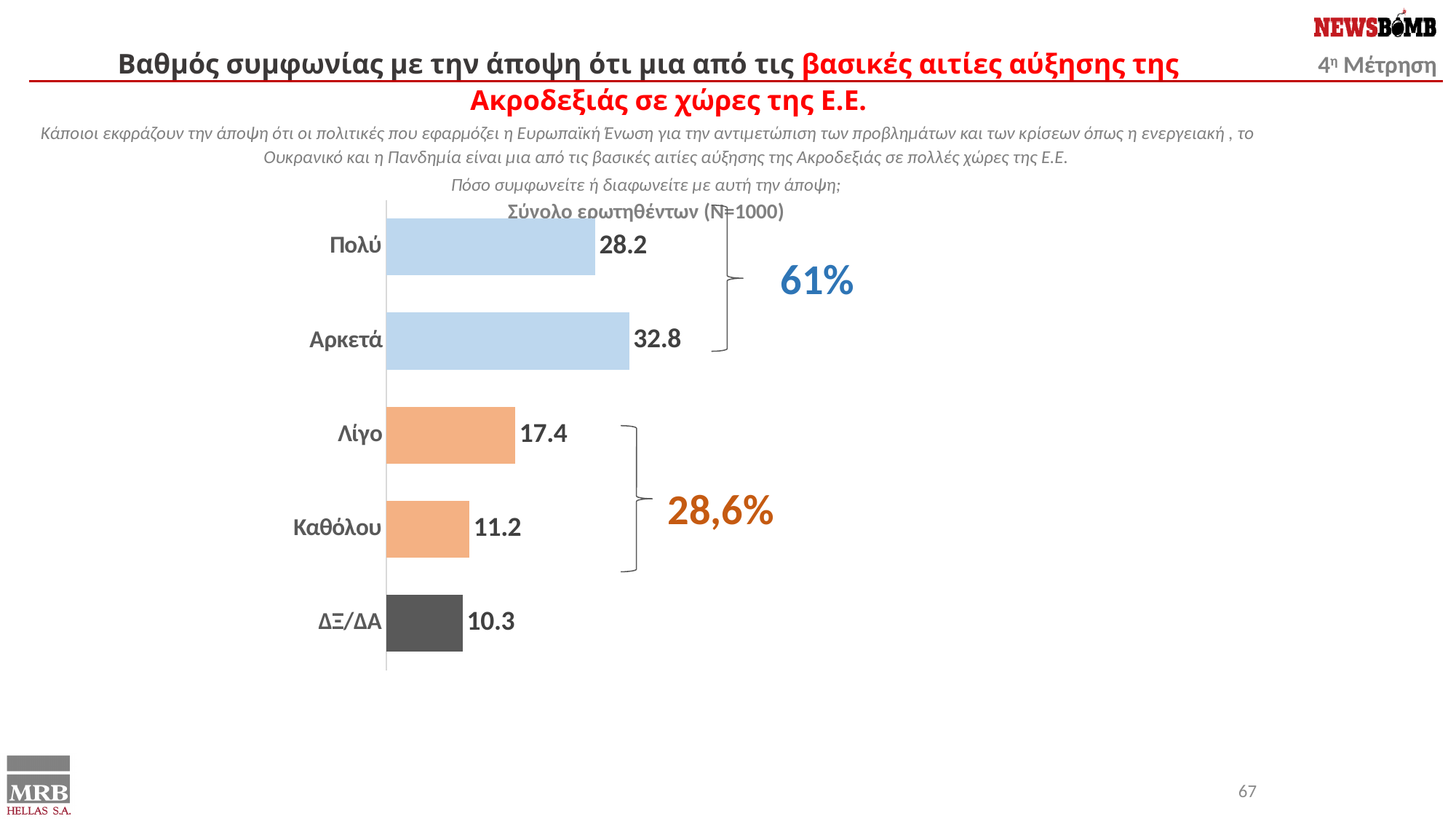
What is the value for Καθόλου? 11.2 What is the difference between the values for Αρκετά and Πολύ? 4.6 How many categories are shown in the chart? 5 Which category has the lowest value? ΔΞ/ΔΑ Which category has the highest value? Αρκετά What combined percentage is shown next to the bracket grouping Πολύ and Αρκετά? 61% What is the value for Αρκετά? 32.8 What is the value for ΔΞ/ΔΑ? 10.3 What kind of chart is shown on the slide? Bar chart Which is larger, the value for Λίγο or the value for Καθόλου? Λίγο What is the value for Λίγο? 17.4 What is the value for Πολύ? 28.2